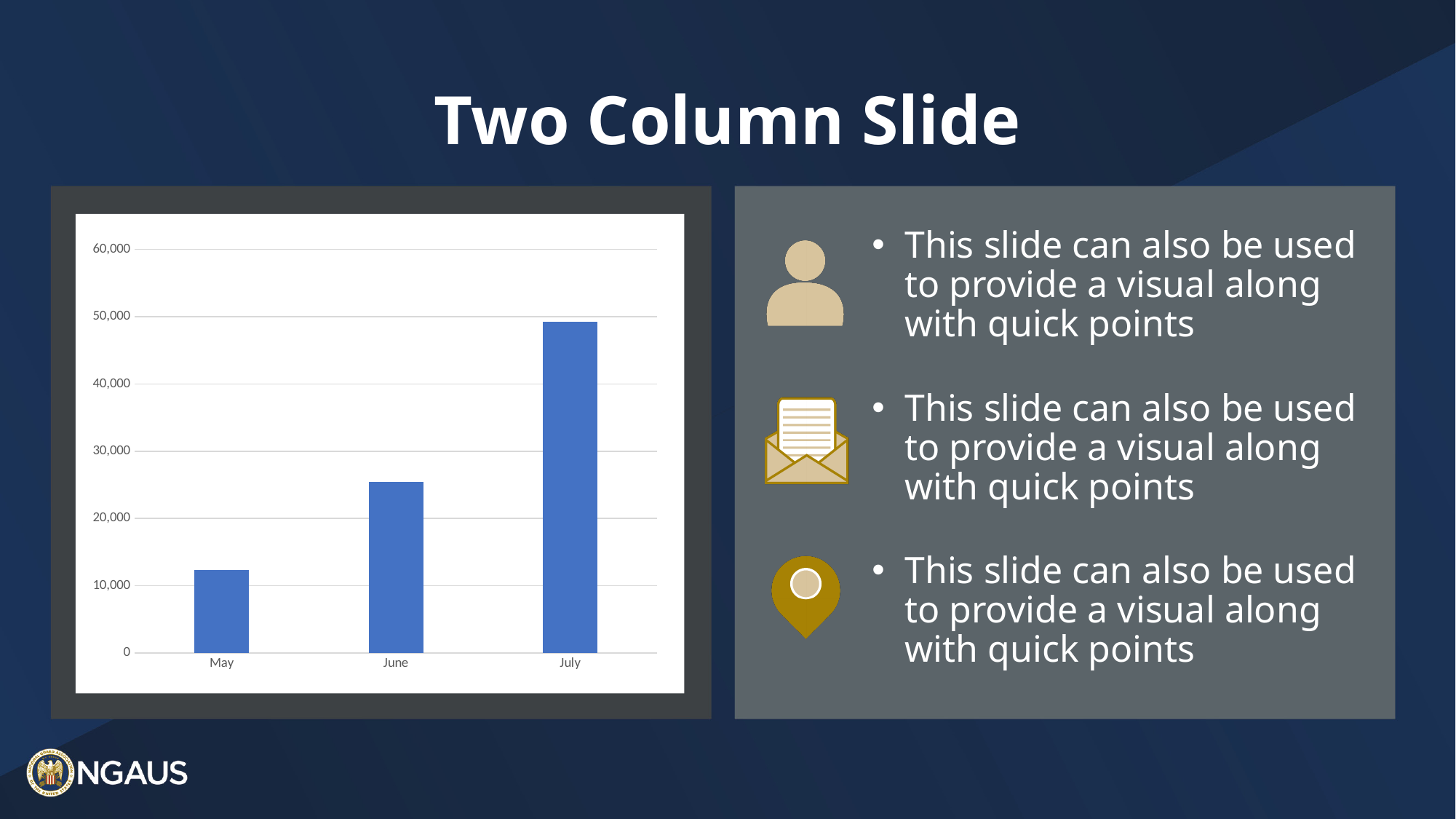
Which month has the lowest bar in the chart? May Which is larger, the value for June or the value for May? June Do the values rise or fall from May to July? rise Is the value for July greater or less than 40,000? greater Which is larger, the value for July or the value for June? July Which month has the highest bar in the chart? July How many categories are shown on the x axis of the chart? 3 What kind of chart is shown on the slide? bar chart Is the value for June greater or less than 20,000? greater Is the value for May greater or less than 20,000? less What is the highest value shown on the chart's vertical axis? 60,000